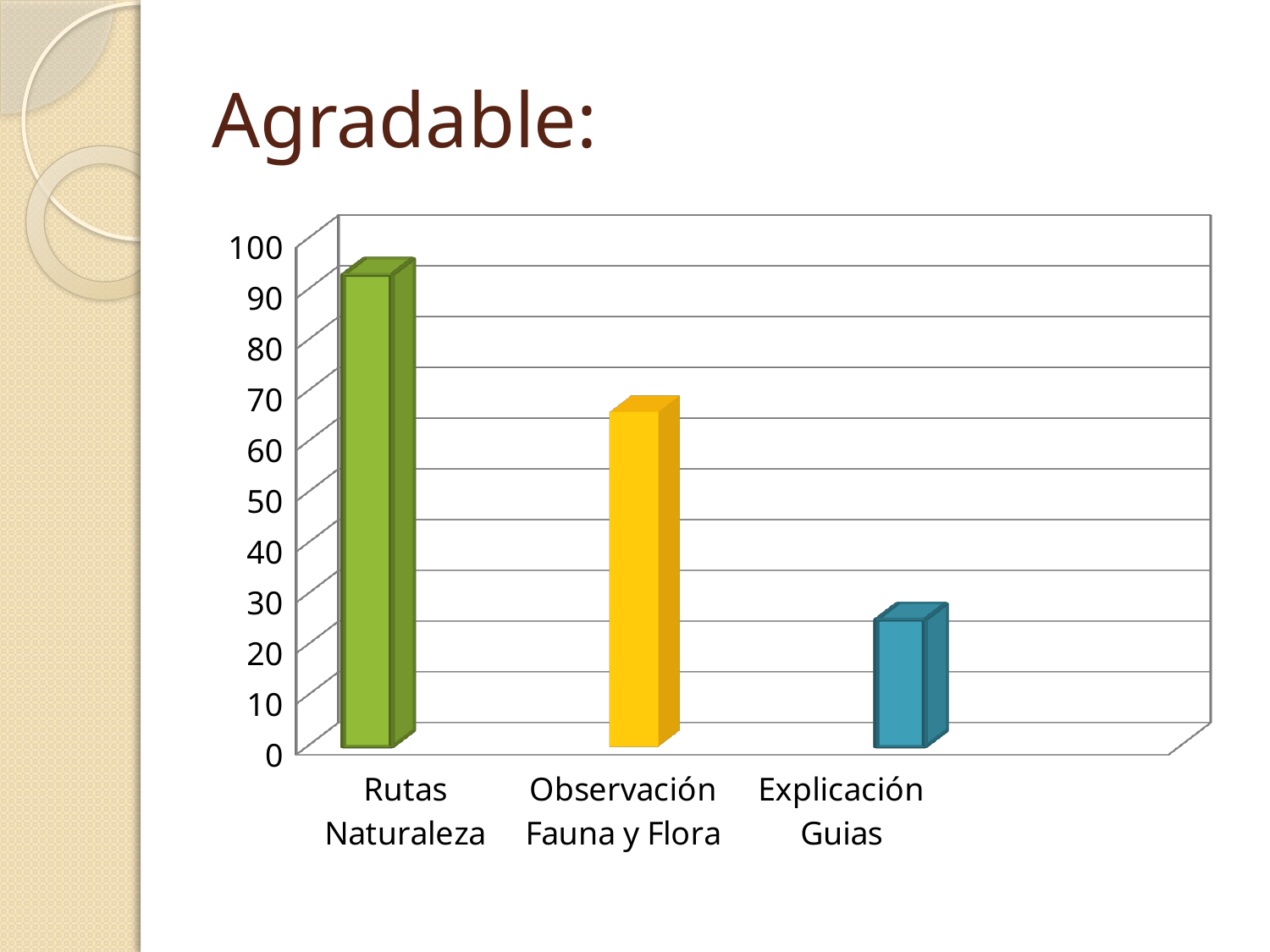
Which category has the highest bar in the chart? Rutas Naturaleza Do the bar values rise or fall from left to right along the x axis? fall Which is larger, the value for Rutas Naturaleza or the value for Observación Fauna y Flora? Rutas Naturaleza Is the value for Observación Fauna y Flora greater or less than 70? less What kind of chart is shown on the slide? bar chart Is the value for Explicación Guias greater or less than 30? less Which category has the lowest bar in the chart? Explicación Guias Is the value for Observación Fauna y Flora greater or less than 60? greater What is the title of the slide containing the chart? Agradable: Which is larger, the value for Observación Fauna y Flora or the value for Explicación Guias? Observación Fauna y Flora How many categories are shown on the x axis of the chart? 3